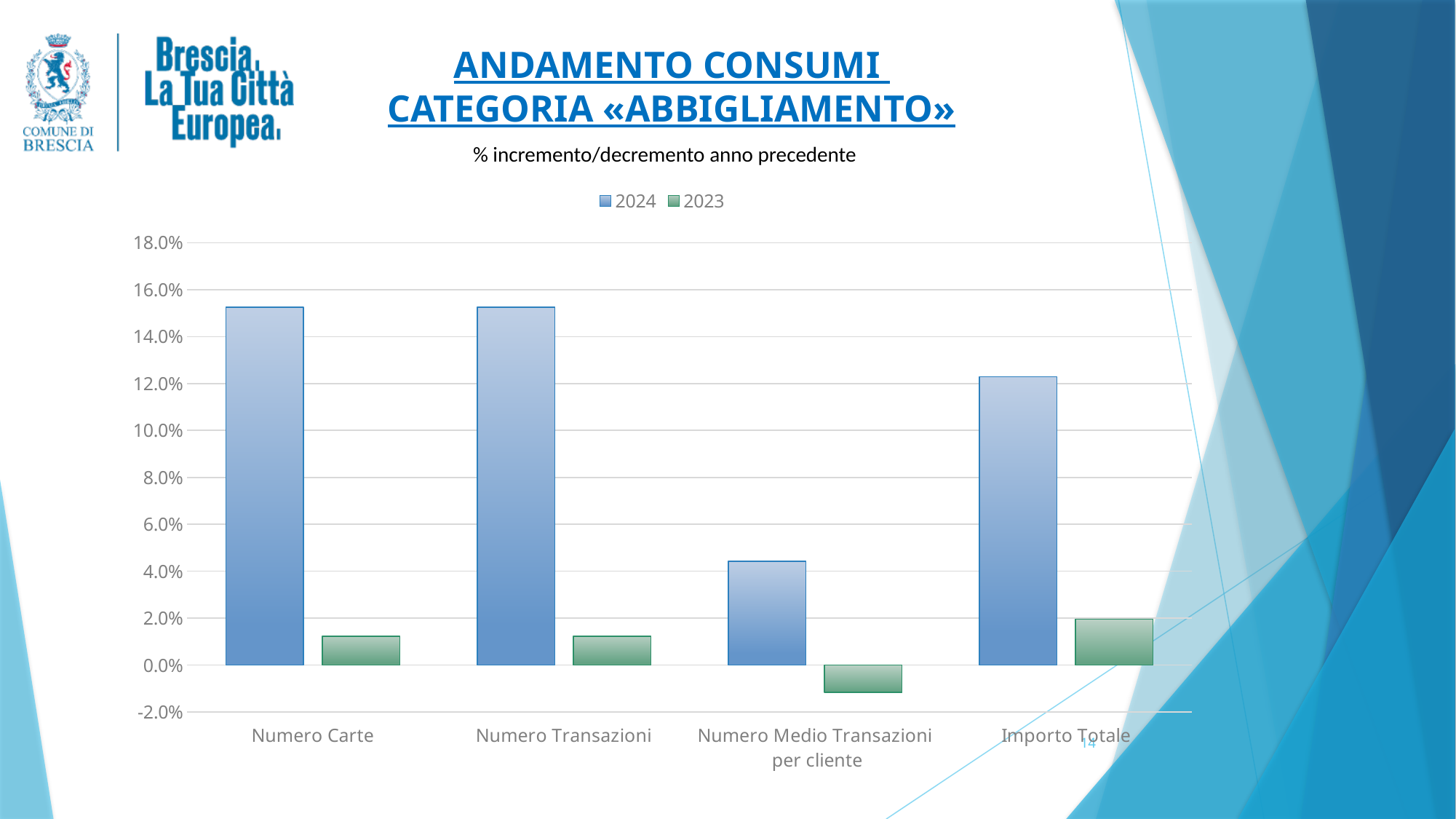
Is the 2024 value for Numero Carte greater or less than 14.0%? greater Is the 2023 value for Numero Medio Transazioni per cliente greater or less than 0.0%? less What kind of chart is shown on the slide? bar chart How many categories are shown on the x axis? 4 Which is larger: the 2024 value for Numero Carte or the 2024 value for Importo Totale? Numero Carte Which category has the highest value for the 2023 series? Importo Totale Which category has the lowest value for the 2024 series? Numero Medio Transazioni per cliente How many series does the legend list? 2 Which series are listed in the legend? 2024 and 2023 Which category has the lowest value for the 2023 series? Numero Medio Transazioni per cliente Is the 2024 value for Importo Totale greater or less than 10.0%? greater